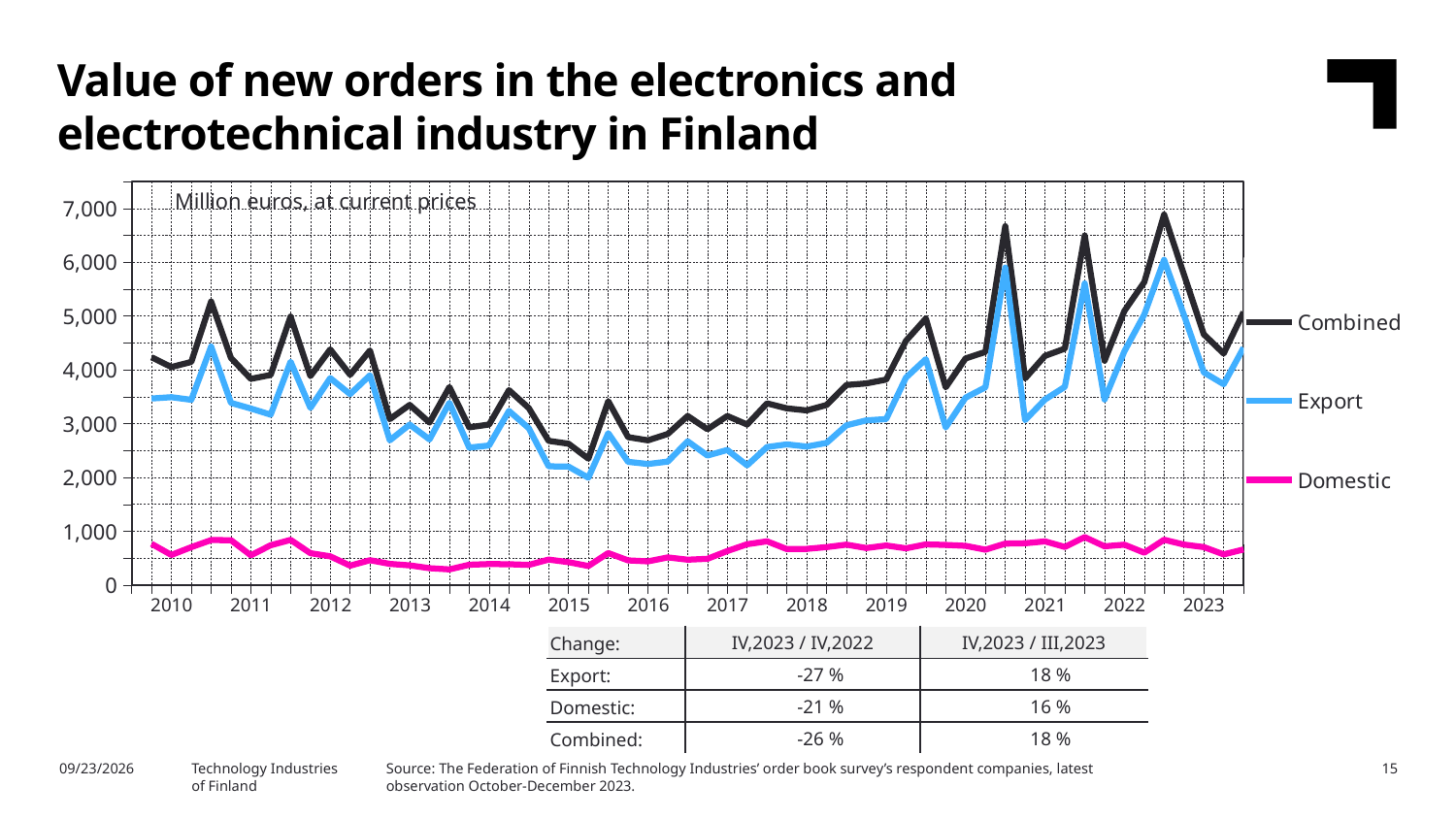
How many series does the legend list? 3 What unit is stated for the values in the chart? Million euros, at current prices How many year labels are shown on the x axis? 14 Is the Export value at the start of 2015 greater or less than 3,000? less What kind of chart is shown on the slide? Line chart Which series are listed in the chart legend? Combined, Export, Domestic Is the Domestic value in 2023 greater or less than 1,000? less Which series has the highest values throughout the chart? Combined Which is larger in 2020, the Combined value or the Domestic value? Combined Which series has the lowest values throughout the chart? Domestic Does the Export series generally rise or fall from 2015 to 2022? Rise Is the peak Combined value in 2022 greater or less than 6,000? greater